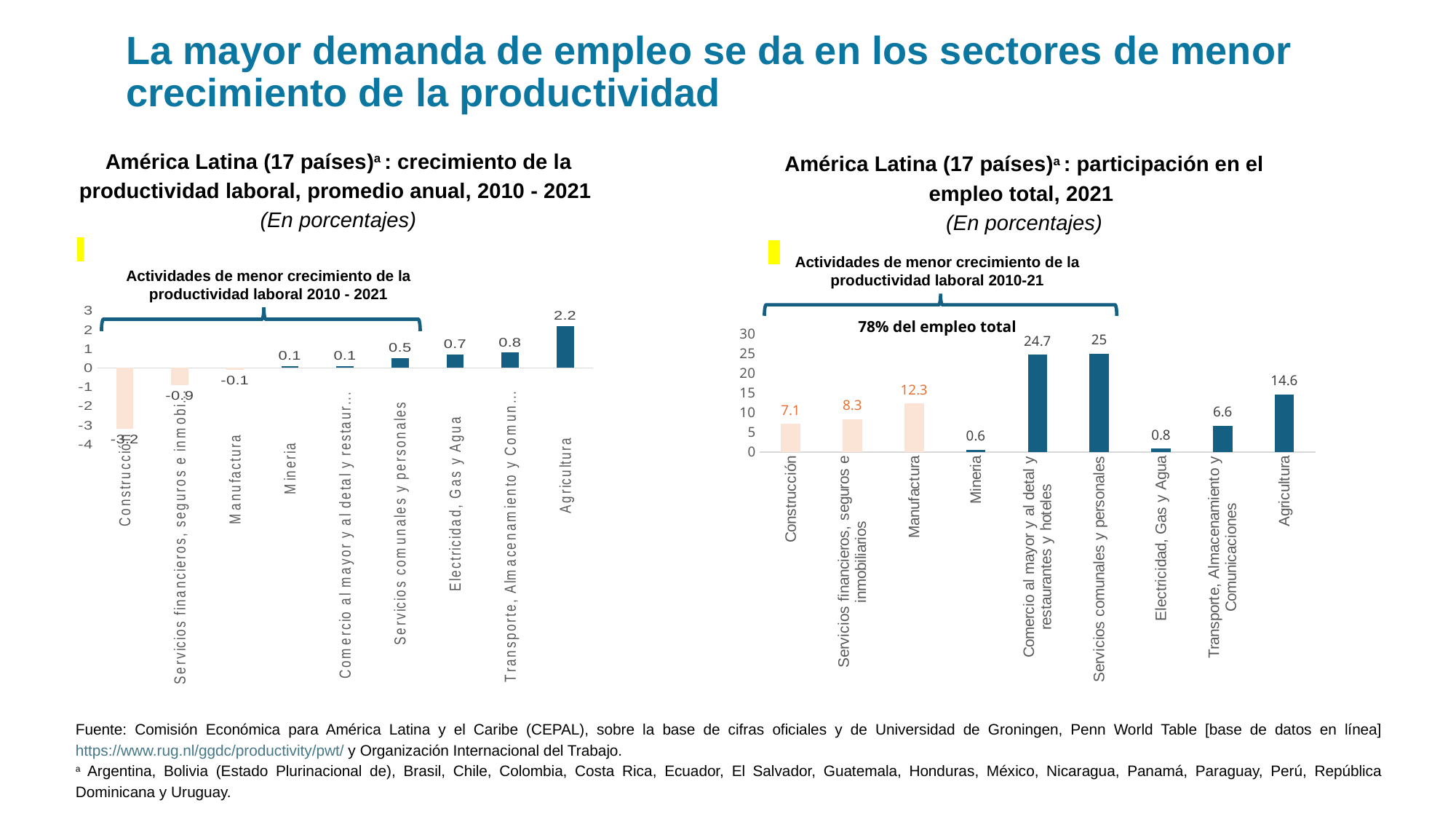
In the right chart (participación en el empleo total, 2021), which sector has the lowest share? Minería In the right chart (participación en el empleo total, 2021), what is the value for Manufactura? 12.3 In the right chart (participación en el empleo total, 2021), which is larger: Comercio al mayor y al detal y restaurantes y hoteles or Agricultura? Comercio al mayor y al detal y restaurantes y hoteles In the left chart (crecimiento de la productividad laboral), what is the value for Servicios financieros, seguros e inmobiliarios? -0.9 In the right chart (participación en el empleo total, 2021), which sector has the highest share? Servicios comunales y personales In the right chart (participación en el empleo total, 2021), what is the difference between Agricultura and Construcción? 7.5 What type of chart is the left chart (crecimiento de la productividad laboral)? Bar chart In the left chart (crecimiento de la productividad laboral), which sector has the highest value? Agricultura In the left chart (crecimiento de la productividad laboral), which sector has the lowest value? Construcción In the left chart (crecimiento de la productividad laboral), what is the difference between Transporte, Almacenamiento y Comunicaciones and Electricidad, Gas y Agua? 0.1 How many sectors are shown in the right chart (participación en el empleo total, 2021)? 9 In the left chart (crecimiento de la productividad laboral), what is the value for Agricultura? 2.2